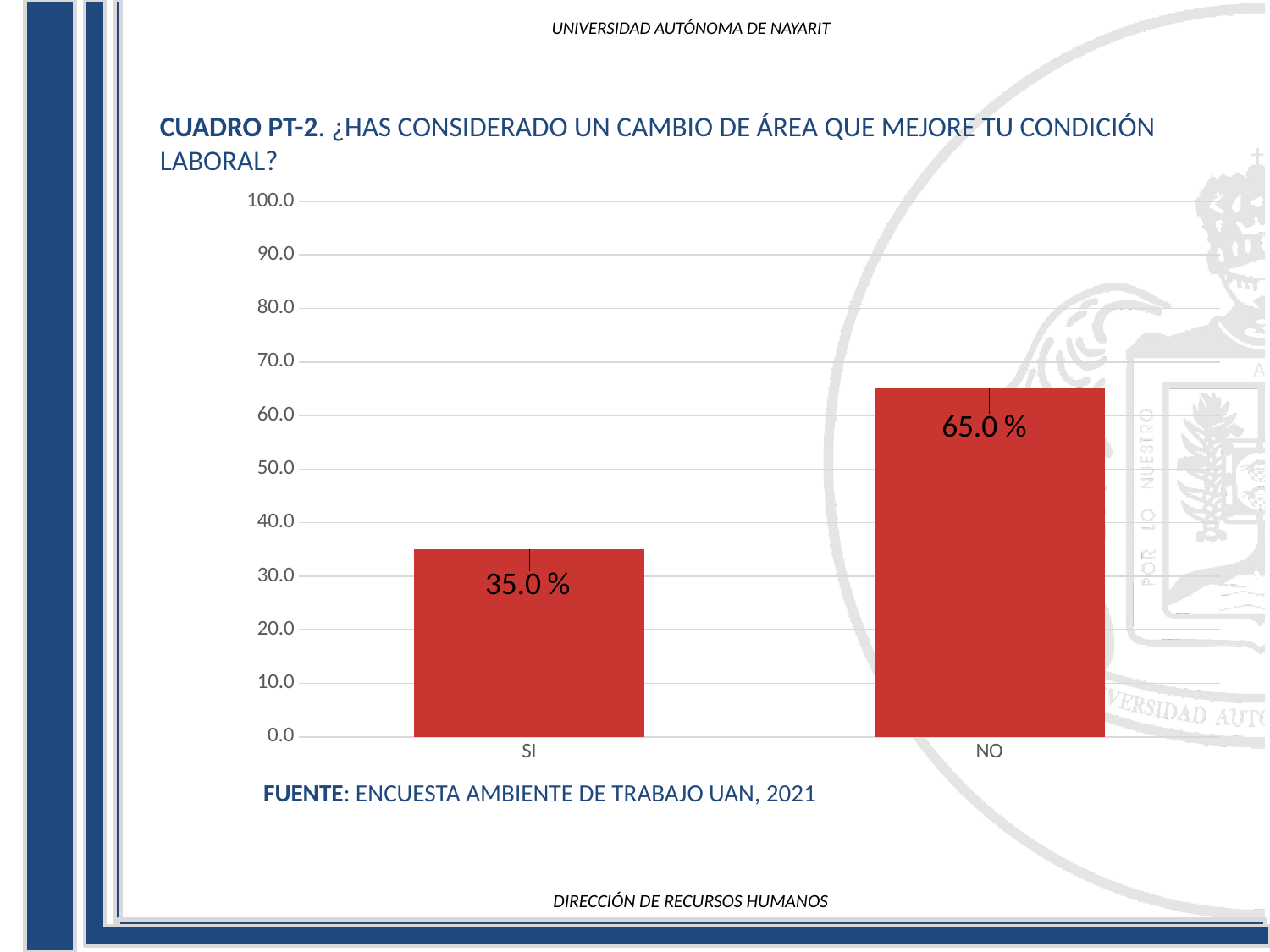
Is the value for NO greater or less than 60.0? greater How many categories are shown on the x axis? 2 Which category has the highest value? NO What is the value for NO? 65.0 % What is the difference between the values for NO and SI? 30.0 % What is the value for SI? 35.0 % Which category has the lowest value? SI What kind of chart is shown on the slide? bar chart Which is larger, the value for SI or the value for NO? NO What is the source cited below the chart? ENCUESTA AMBIENTE DE TRABAJO UAN, 2021 What is the total of the two bar values? 100.0 % Is the value for SI greater or less than 40.0? less